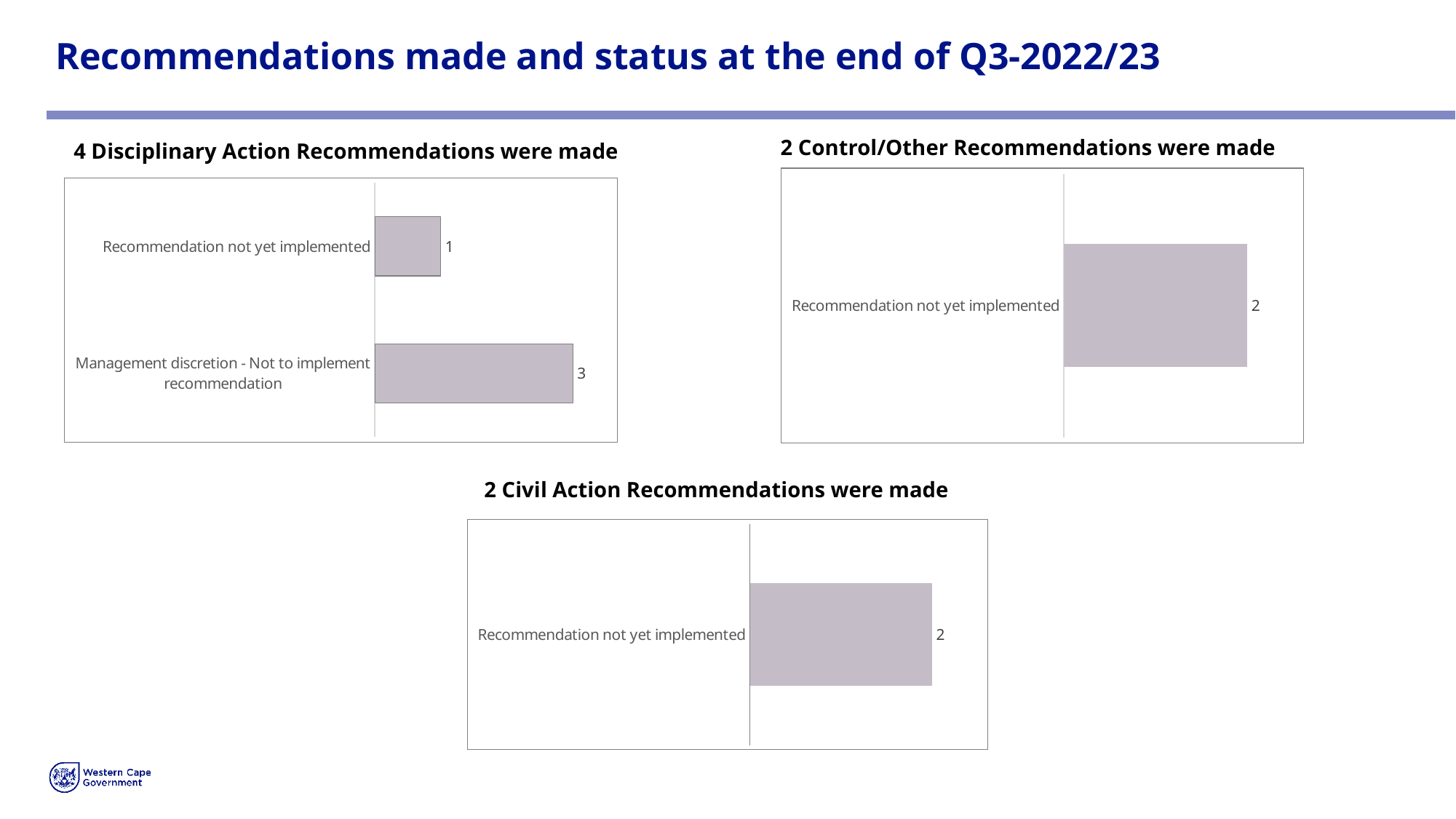
How many charts are shown on the slide? 3 In the '2 Civil Action Recommendations were made' chart, what is the value for 'Recommendation not yet implemented'? 2 What is the title of the chart at the bottom of the slide? 2 Civil Action Recommendations were made In the '2 Control/Other Recommendations were made' chart, what is the value for 'Recommendation not yet implemented'? 2 In the '4 Disciplinary Action Recommendations were made' chart, which category has the highest value? Management discretion - Not to implement recommendation In the '4 Disciplinary Action Recommendations were made' chart, what is the value for 'Management discretion - Not to implement recommendation'? 3 In the '4 Disciplinary Action Recommendations were made' chart, what is the difference between 'Management discretion - Not to implement recommendation' and 'Recommendation not yet implemented'? 2 In the '4 Disciplinary Action Recommendations were made' chart, which category has the lowest value? Recommendation not yet implemented In the '2 Civil Action Recommendations were made' chart, how many categories are shown? 1 In the '4 Disciplinary Action Recommendations were made' chart, how many categories are shown? 2 What kind of chart is the '2 Control/Other Recommendations were made' chart? Bar chart In the '4 Disciplinary Action Recommendations were made' chart, what is the value for 'Recommendation not yet implemented'? 1